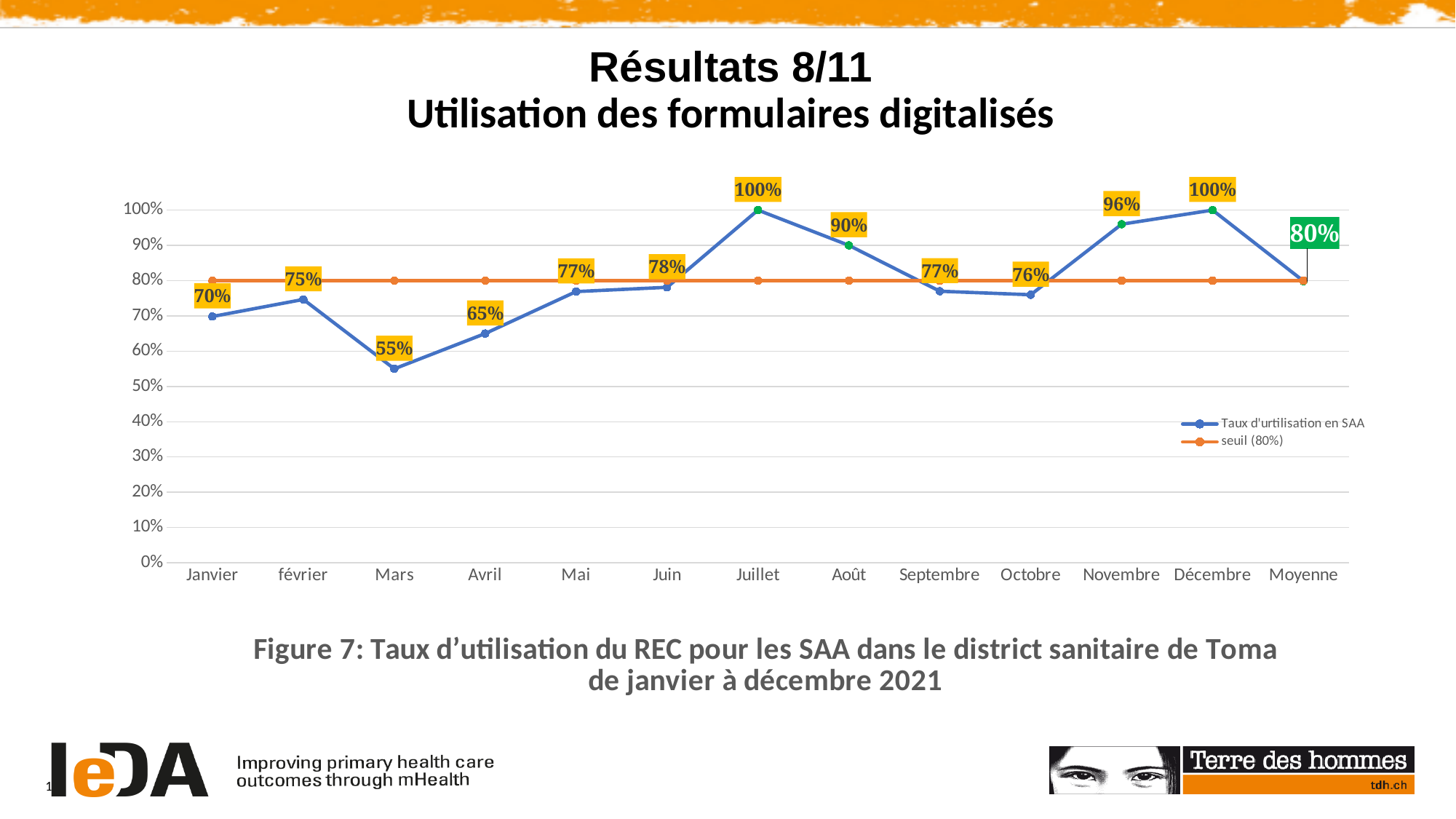
What is the name of the second series in the legend? seuil (80%) Which is larger, the value for Août or the value for Septembre? Août How many categories are shown on the x axis? 13 What kind of chart is shown on the slide? line chart How many series does the legend list? 2 What is the value of 'Taux d'urtilisation en SAA' for Novembre? 96% What is the value of 'Taux d'urtilisation en SAA' for Mars? 55% Is the value for Avril greater or less than 70%? less What is the value shown for Moyenne? 80% What is the difference between the values for Juillet and Janvier? 30% Does the 'Taux d'urtilisation en SAA' rise or fall from Octobre to Décembre? rise Which month has the lowest 'Taux d'urtilisation en SAA'? Mars